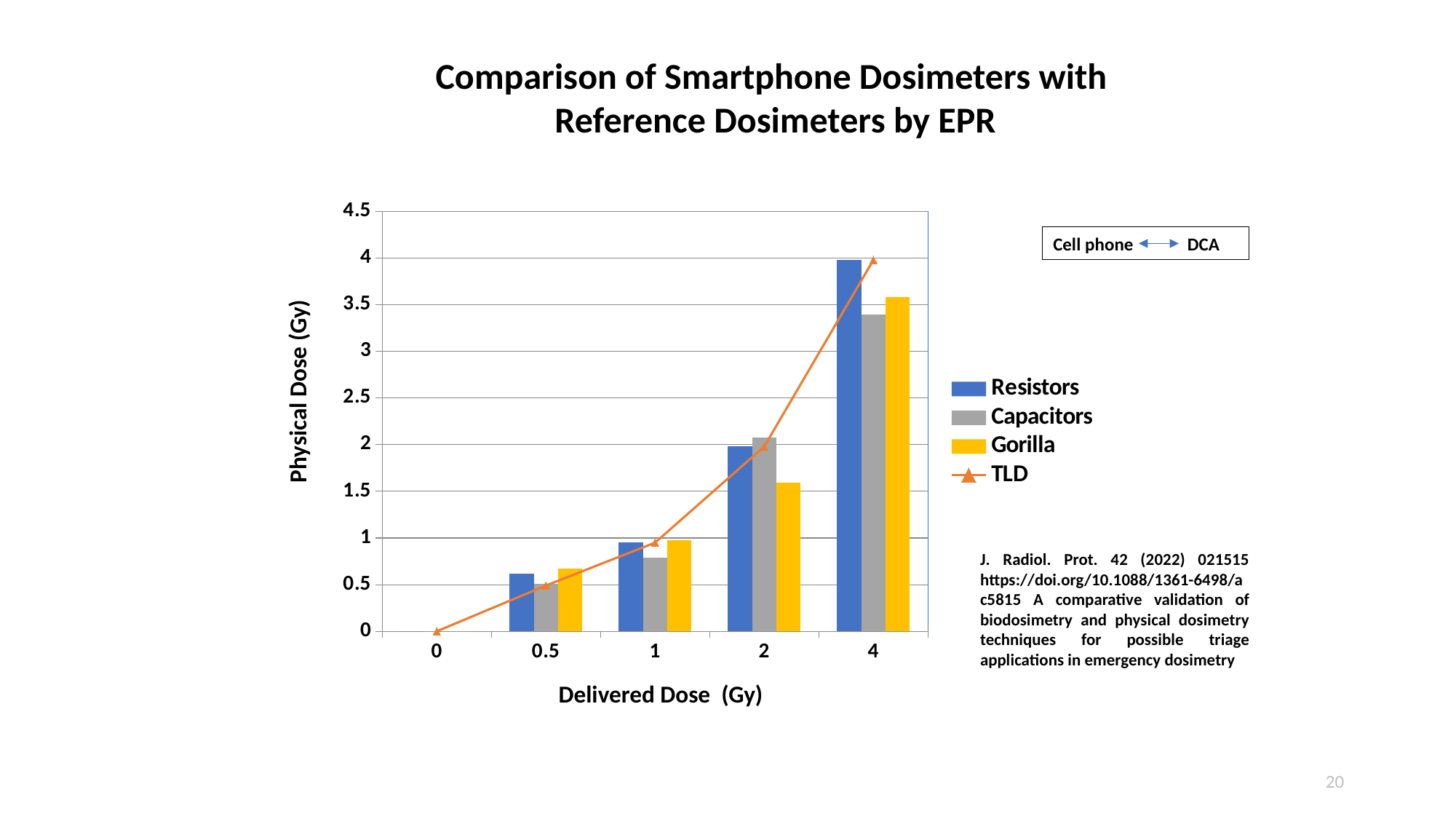
Is the Capacitors value at a delivered dose of 4 Gy greater or less than 3.5? less What kind of chart is shown on the slide? combination bar and line chart Is the Resistors value at a delivered dose of 0.5 Gy greater or less than 0.5? greater Does the TLD line rise or fall as the delivered dose increases along the x axis? rises How many delivered dose categories are shown on the x axis? 5 At a delivered dose of 4 Gy, which is larger, the Resistors bar or the Capacitors bar? Resistors What is the title of the y axis? Physical Dose (Gy) How many series does the legend list? 4 What is the TLD value at a delivered dose of 0 Gy? 0 At a delivered dose of 2 Gy, which series has the lowest bar? Gorilla Is the Resistors value at a delivered dose of 4 Gy greater or less than 3.5? greater